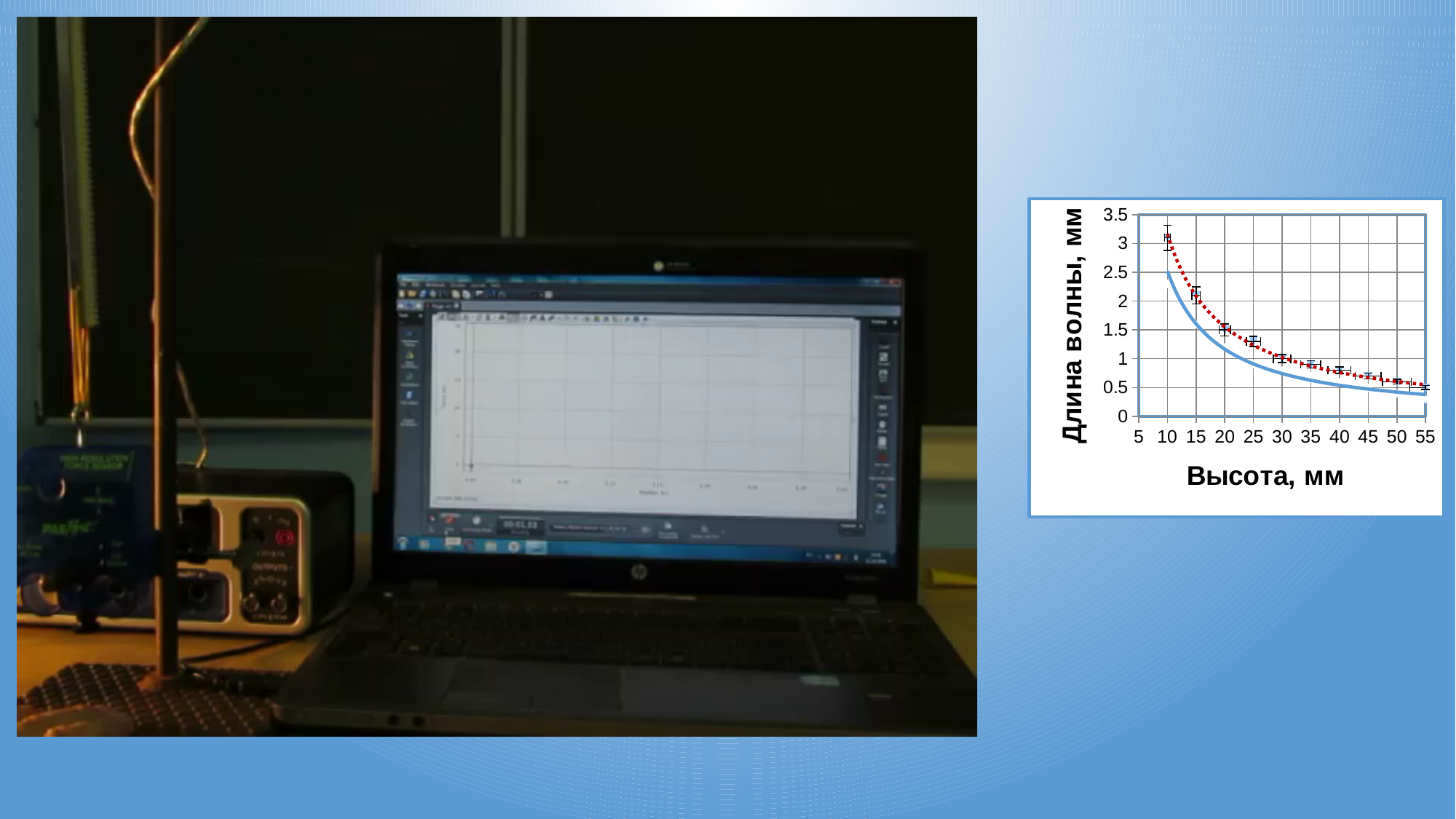
At which height value is the plotted wavelength lowest? 55 What is the label of the x axis of the chart? Высота, мм How many data points with error bars are plotted on the chart? 10 What is the label of the y axis of the chart? Длина волны, мм Which has the larger plotted wavelength: a height of 15 mm or a height of 40 mm? 15 mm Is the plotted wavelength at a height of 55 mm greater or less than 1? less What kind of chart is shown on the right side of the slide? Scatter chart with fitted curves Is the plotted wavelength at a height of 20 mm greater or less than 1? greater Do the plotted values rise or fall as the height (Высота) increases along the x axis? Fall Is the plotted wavelength at a height of 40 mm greater or less than 1.5? less At which height value is the plotted wavelength highest? 10